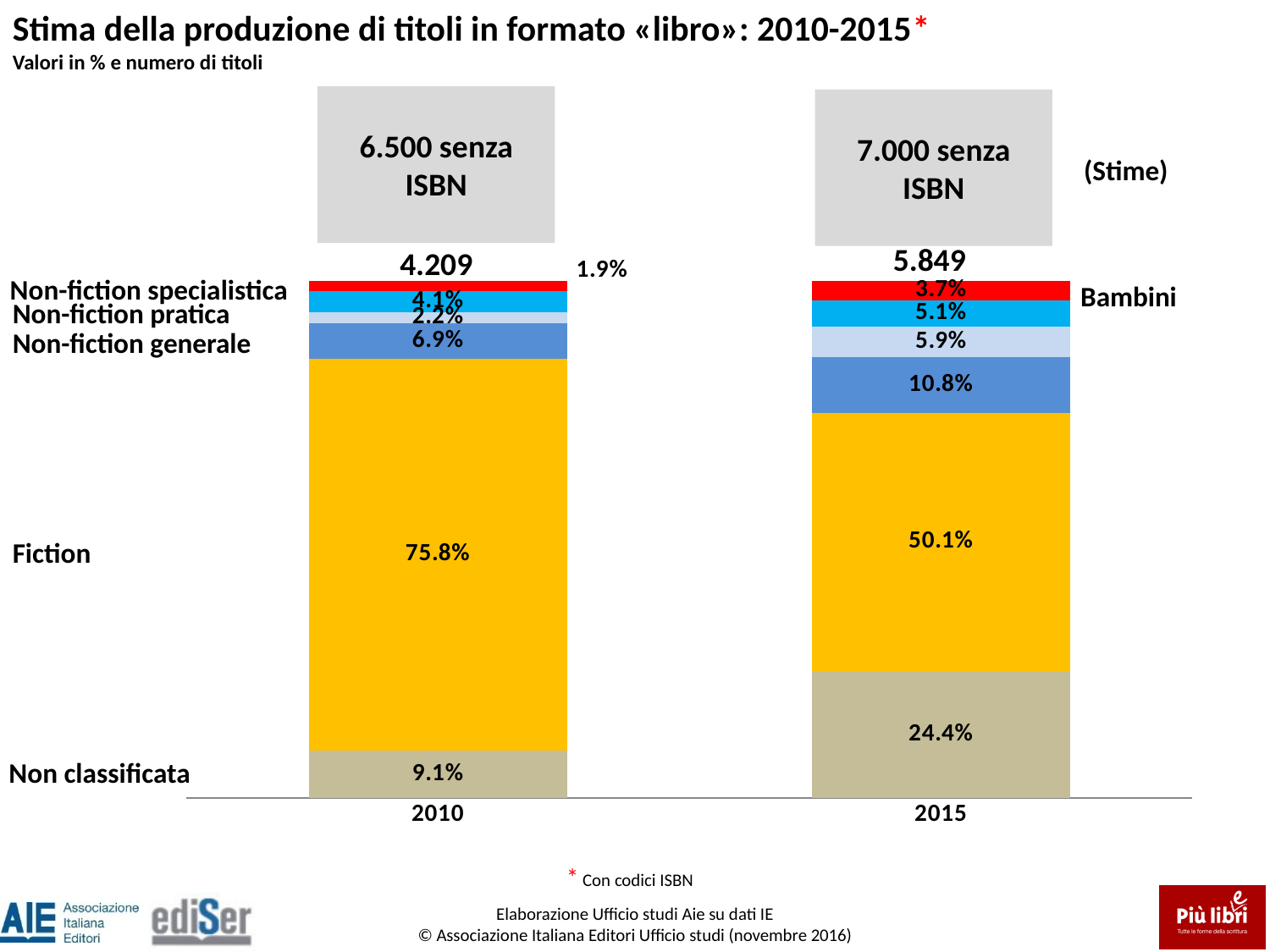
Which year has the larger Non classificata share, 2010 or 2015? 2015 What number of titles is printed above the 2010 bar? 4.209 Does the Fiction share rise or fall from 2010 to 2015? Fall What is the Non-fiction generale share in 2015? 10.8% What number of titles is printed above the 2015 bar? 5.849 What is the Fiction share of the 2010 bar? 75.8% By how many percentage points did the Fiction share fall from 2010 to 2015? 25.7 percentage points What kind of chart is shown on the slide? Stacked bar chart What is the Non classificata share in 2015? 24.4% What is the Bambini share in 2015? 3.7% What is the Fiction share of the 2015 bar? 50.1% Which category has the largest share in the 2015 bar? Fiction